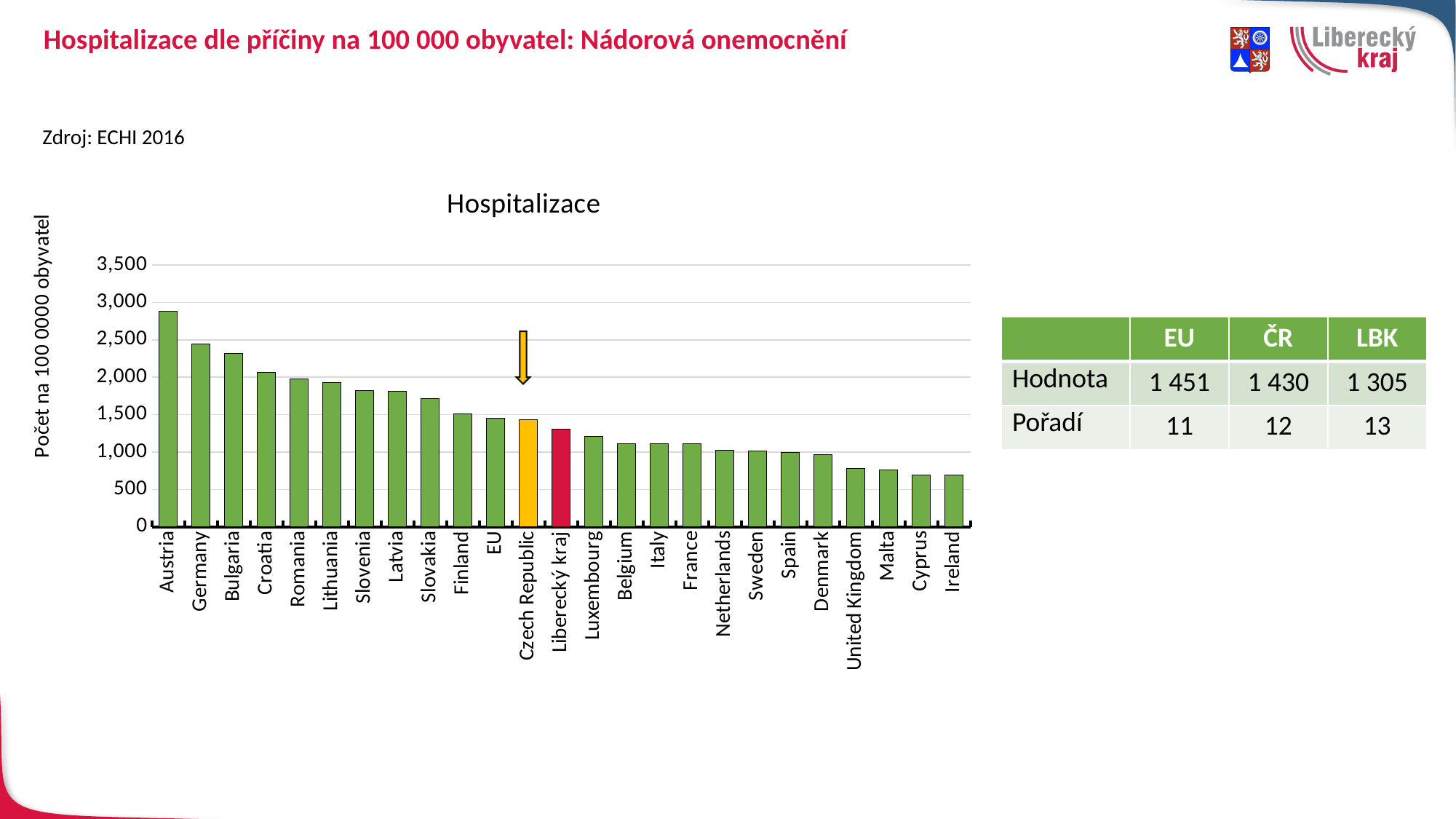
Is the value for Bulgaria greater or less than 2,000? greater Which category has the highest value in the chart? Austria Which has a larger value, Croatia or Finland? Croatia What is the value for Liberecký kraj (LBK) according to the slide? 1 305 Is the value for Ireland greater or less than 1,000? less What is the difference between the EU value and the LBK value? 146 Is the value for Austria greater or less than 2,500? greater What is the title of the chart? Hospitalizace What is the value for EU according to the slide? 1 451 Do the values rise or fall from left to right along the x axis? fall What type of chart is shown on the slide? bar chart How many categories (bars) are shown in the chart? 25